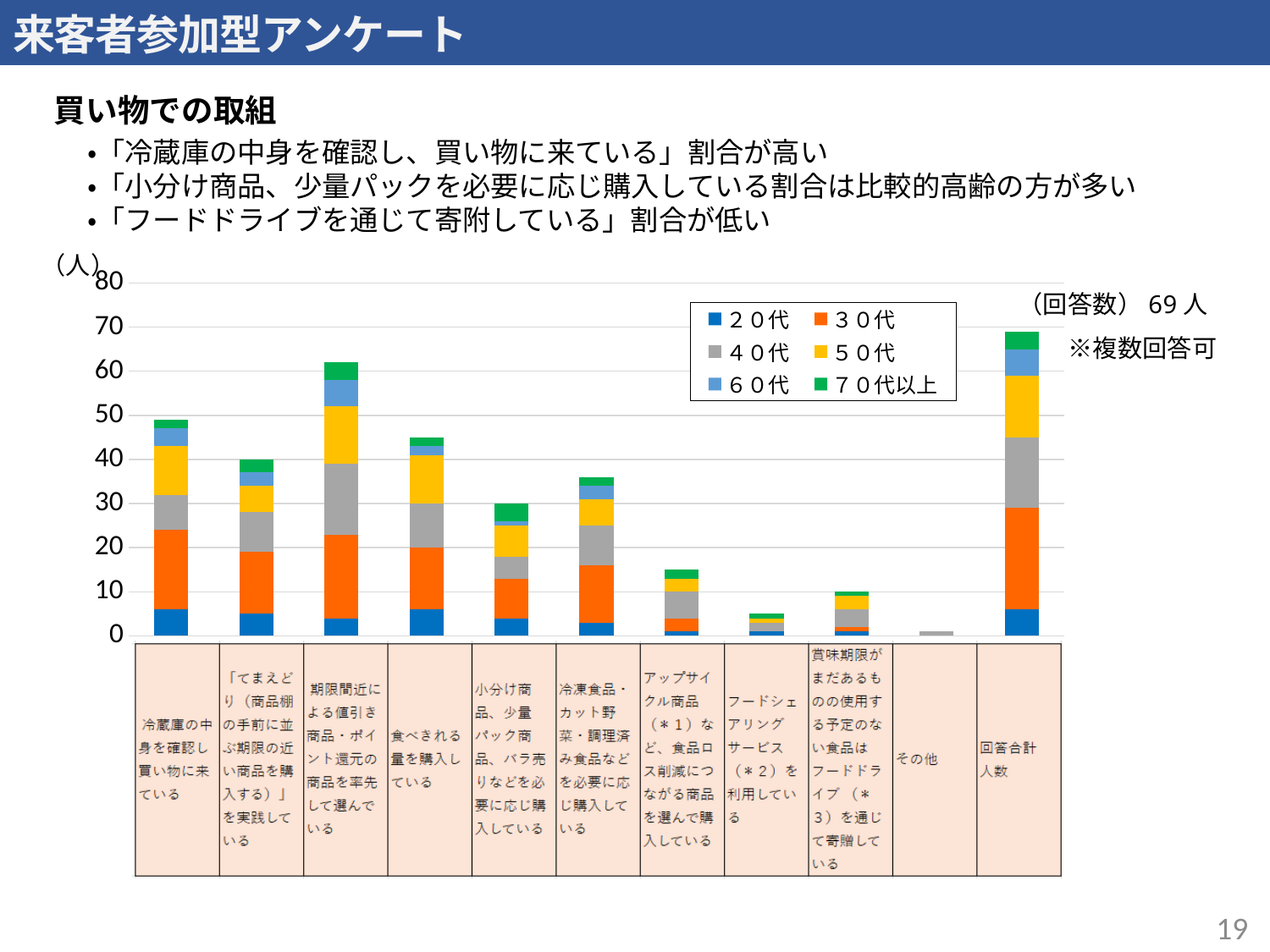
Is the total for 「冷蔵庫の中身を確認し買い物に来ている」 greater or less than 40? greater How many categories are shown along the x axis of the chart? 11 Which category has the highest total bar? 回答合計人数 What kind of chart is shown on the slide? Stacked bar chart Which has the larger total bar: 「てまえどり」を実践している or 食べきれる量を購入している? 食べきれる量を購入している How many series does the legend list? 6 Is the total for 「期限間近による値引き商品・ポイント還元の商品を率先して選んでいる」 greater or less than 50? greater Is the total for 「アップサイクル商品（＊1）など、食品ロス削減につながる商品を選んで購入している」 greater or less than 20? less Which category has the lowest total bar? その他 Which has the larger total bar: 小分け商品、少量パック商品、バラ売りなどを必要に応じ購入している or 冷凍食品・カット野菜・調理済み食品などを必要に応じ購入している? 冷凍食品・カット野菜・調理済み食品などを必要に応じ購入している According to the annotation on the slide, how many respondents (回答数) were there? 69人